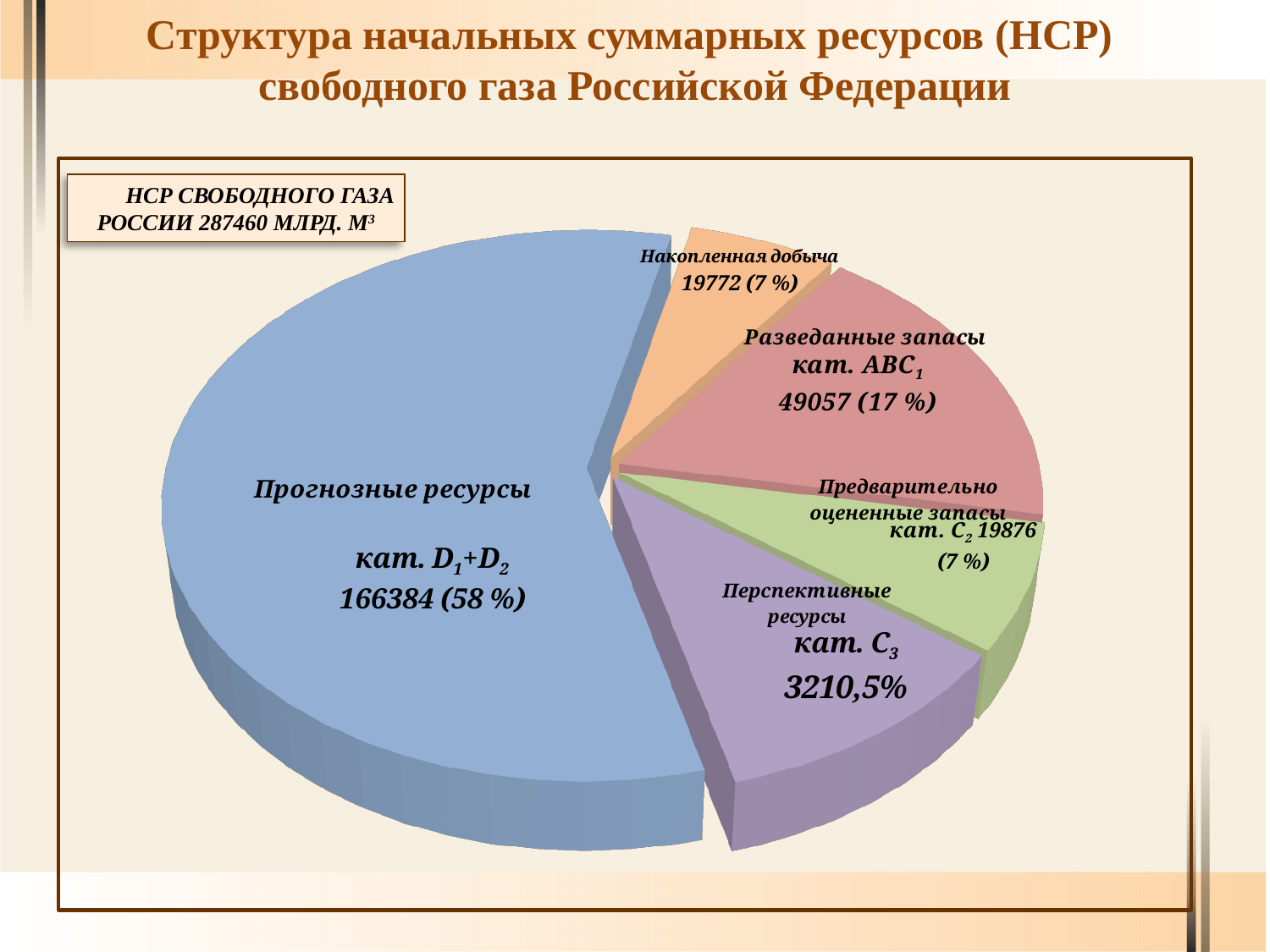
What total НСР свободного газа России is stated in the box on the chart? 287460 млрд. м³ Which category has the largest slice of the pie? Прогнозные ресурсы кат. D1+D2 What share of the pie do Прогнозные ресурсы кат. D1+D2 represent? 58 % How many slices does the pie chart have? 5 Which is larger: Разведанные запасы кат. ABC1 or Предварительно оцененные запасы кат. C2? Разведанные запасы кат. ABC1 What is the difference between Разведанные запасы кат. ABC1 (49057) and Накопленная добыча (19772)? 29285 What value is shown for Предварительно оцененные запасы кат. C2? 19876 (7 %) What value is shown for Накопленная добыча? 19772 (7 %) What colour is the slice for Прогнозные ресурсы кат. D1+D2? blue What kind of chart is shown on the slide? pie chart What value is shown for Разведанные запасы кат. ABC1? 49057 (17 %) What value is shown for Прогнозные ресурсы кат. D1+D2? 166384 (58 %)